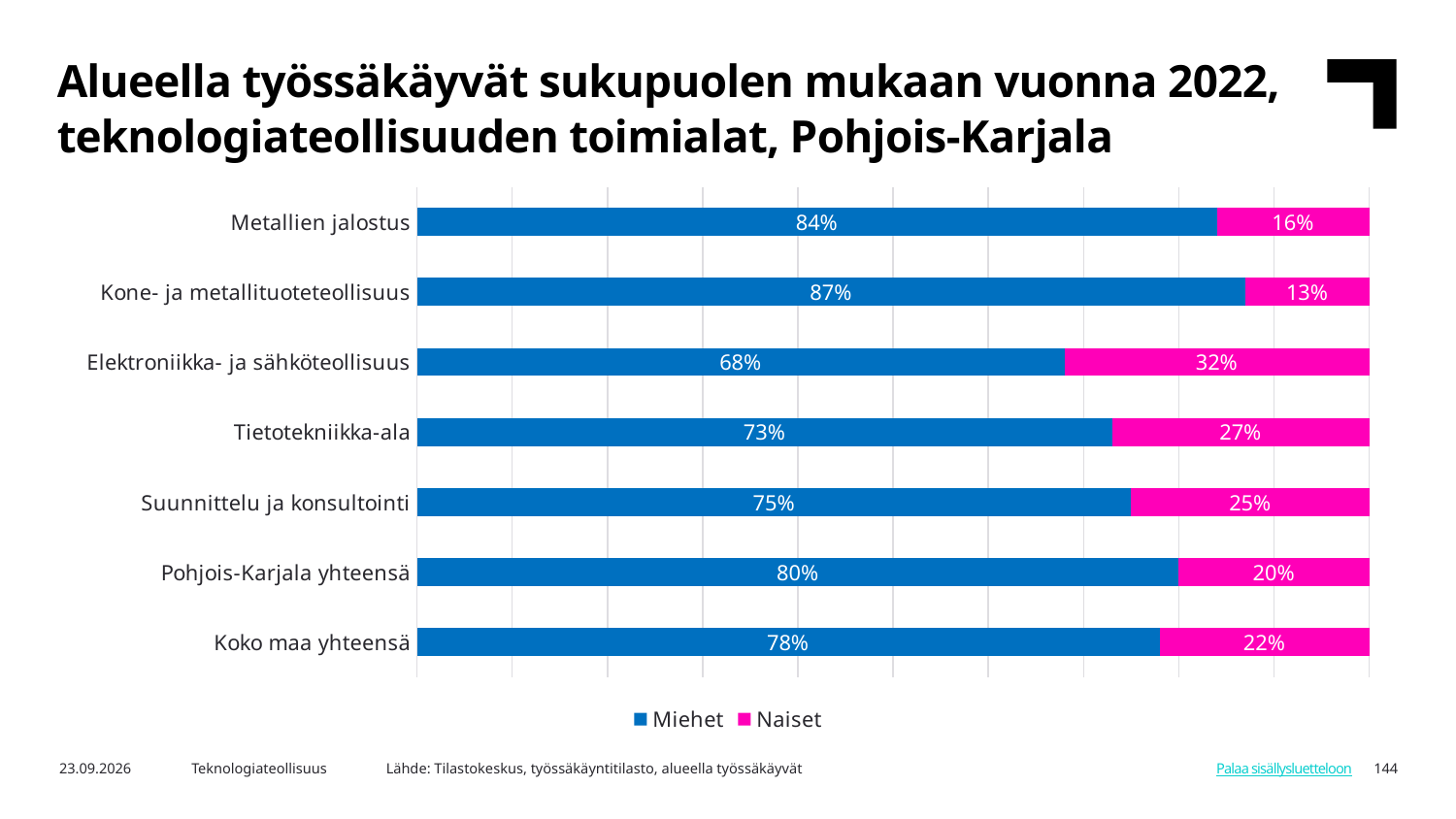
What is the total of the stacked bar for Tietotekniikka-ala? 100% What is the Naiset share for Elektroniikka- ja sähköteollisuus? 32% How many categories are shown on the chart? 7 Which is larger: the Miehet share for Pohjois-Karjala yhteensä or for Koko maa yhteensä? Pohjois-Karjala yhteensä What kind of chart is shown on the slide? Stacked bar chart Which colour represents the Naiset series? Magenta (pink) What is the Naiset share for Koko maa yhteensä? 22% Which category has the lowest Naiset share? Kone- ja metallituoteteollisuus How many series does the legend list? 2 Which category has the highest Miehet share? Kone- ja metallituoteteollisuus What is the Miehet share for Metallien jalostus? 84% What is the difference between the Naiset share for Tietotekniikka-ala and for Suunnittelu ja konsultointi? 2 percentage points